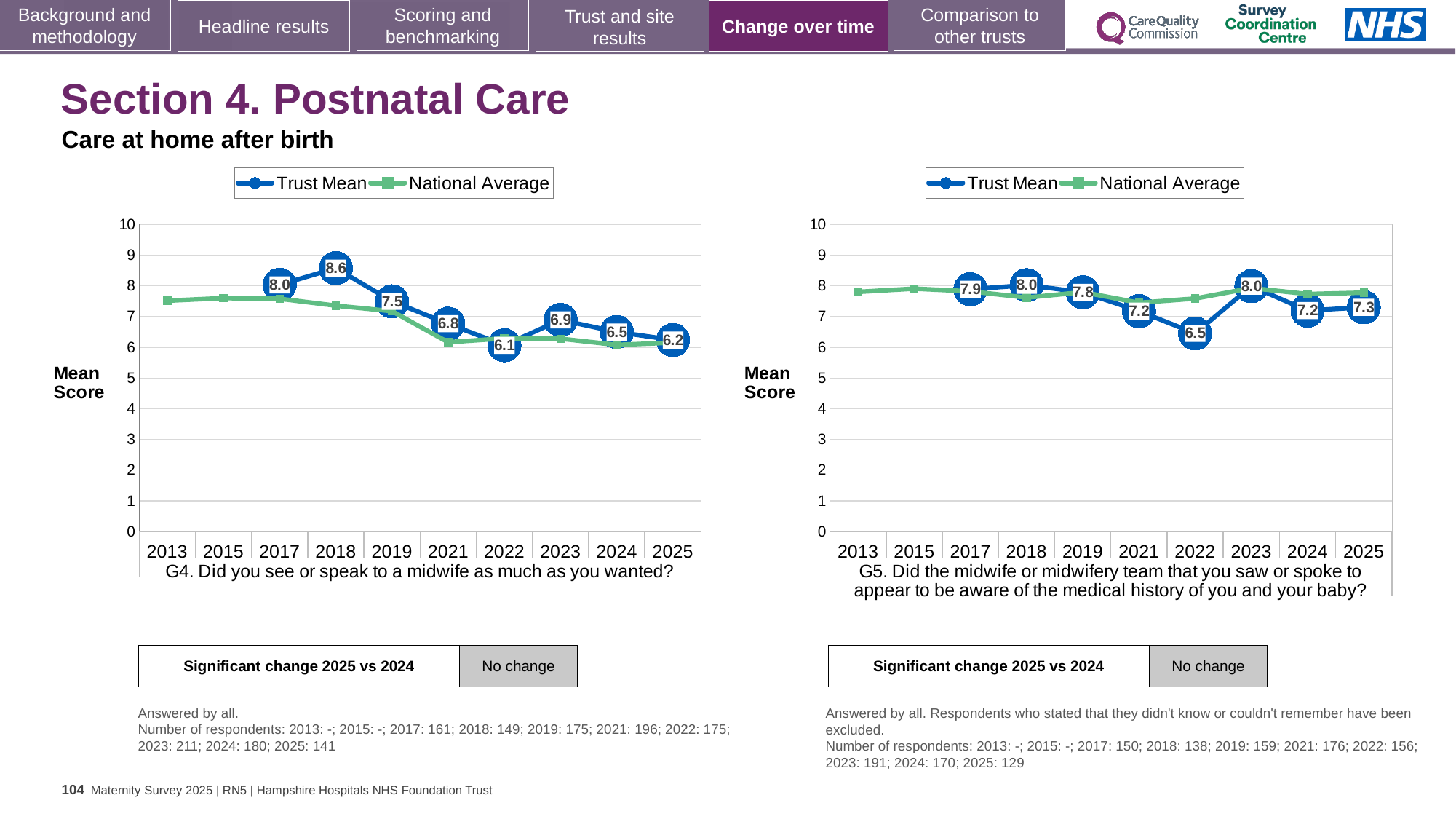
What kind of chart is the G4 chart on the left? Line chart In the G5 chart on the right, what is the difference between the Trust Mean in 2025 and in 2024? 0.1 In the G4 chart on the left, what is the difference between the Trust Mean in 2018 and in 2022? 2.5 In the G4 chart on the left, is the National Average for 2013 greater or less than 7? greater In the G4 chart on the left, what is the Trust Mean for 2018? 8.6 In the G4 chart on the left, what is the Trust Mean for 2025? 6.2 In the G4 chart on the left, which year has the highest Trust Mean? 2018 In the G5 chart on the right, is the Trust Mean higher in 2023 or in 2024? 2023 How many series does the legend of the G5 chart on the right list? 2 In the G5 chart on the right, what is the Trust Mean for 2022? 6.5 In the G4 chart on the left, which year has the lowest Trust Mean? 2022 In the G5 chart on the right, which year has the lowest Trust Mean? 2022